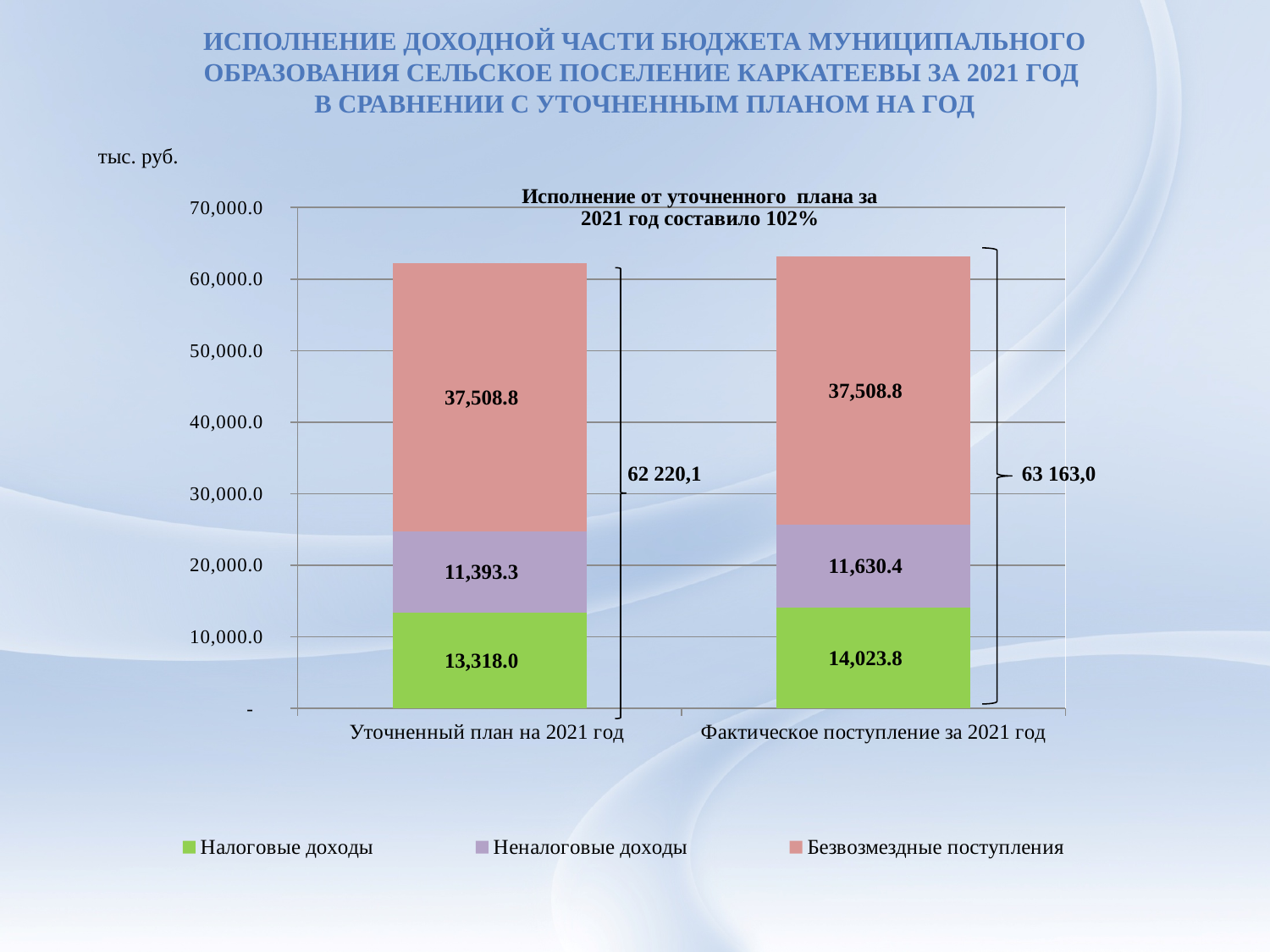
What is the value of Безвозмездные поступления for Уточненный план на 2021 год? 37,508.8 How many categories are shown on the x axis? 2 What is the value of Налоговые доходы for Уточненный план на 2021 год? 13,318.0 What is the value of Налоговые доходы for Фактическое поступление за 2021 год? 14,023.8 How many series does the legend list? 3 What type of chart is shown on the slide? stacked bar chart What is the value of Неналоговые доходы for Фактическое поступление за 2021 год? 11,630.4 What is the total of the stacked bar for Фактическое поступление за 2021 год? 63 163,0 Which is larger: Неналоговые доходы for Уточненный план на 2021 год or for Фактическое поступление за 2021 год? Фактическое поступление за 2021 год Which series has the largest value in the Фактическое поступление за 2021 год bar? Безвозмездные поступления What is the total of the stacked bar for Уточненный план на 2021 год? 62 220,1 What is the difference between Налоговые доходы for Фактическое поступление за 2021 год and for Уточненный план на 2021 год? 705.8